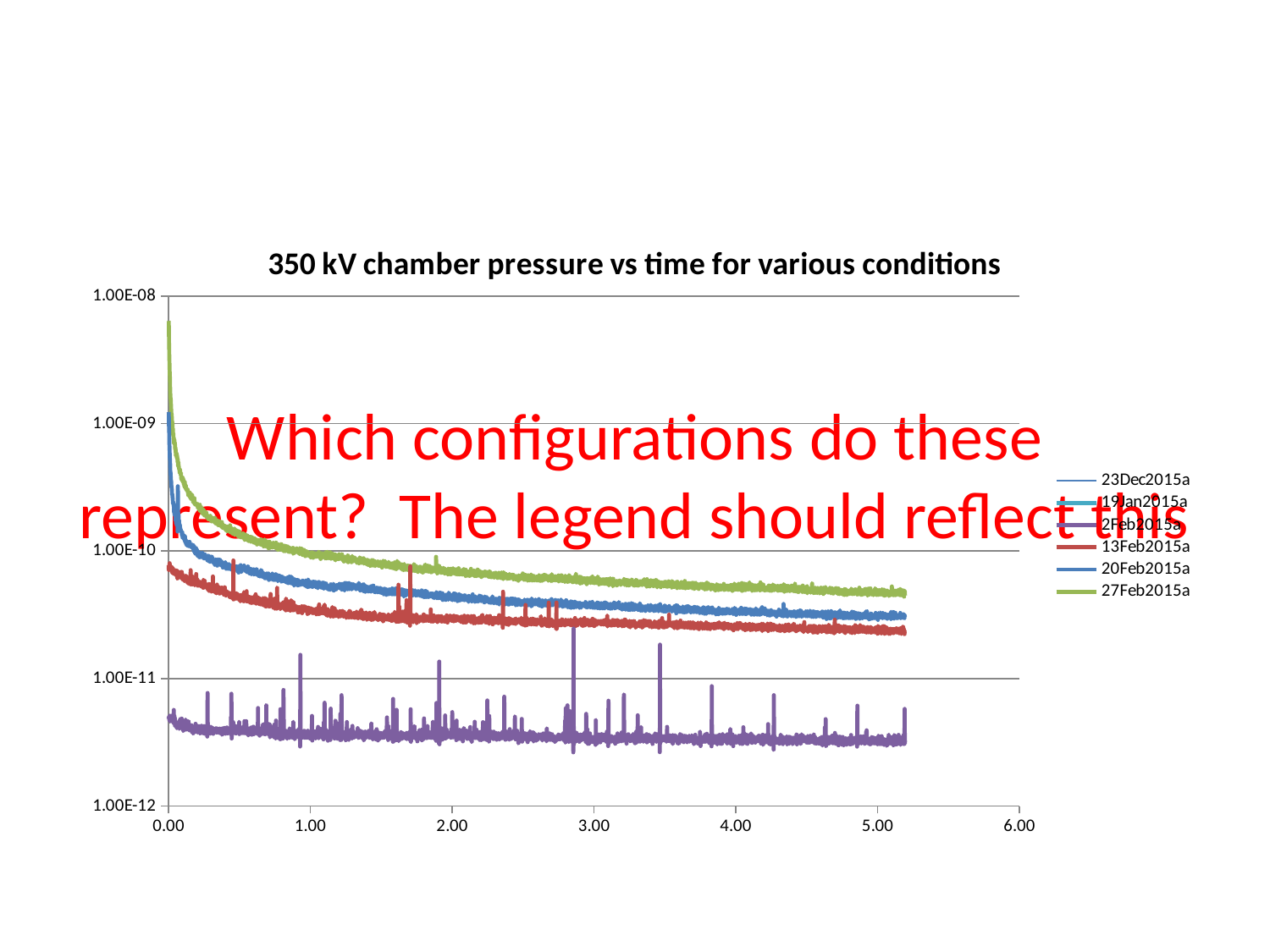
How many series does the legend list? 6 Which series has the highest pressure values across the plotted time range? 27Feb2015a At x = 4.00, which series has the higher value, 20Feb2015a or 2Feb2015a? 20Feb2015a What is the title of the chart? 350 kV chamber pressure vs time for various conditions Is the value for 13Feb2015a at x = 3.00 greater or less than 1.00E-10? less Do the pressure values for the 27Feb2015a series rise or fall as time increases along the x axis? fall Is the value for 2Feb2015a at x = 4.00 greater or less than 1.00E-11? less Which series has the lowest pressure values across the plotted time range? 2Feb2015a At x = 3.00, which series has the higher value, 27Feb2015a or 13Feb2015a? 27Feb2015a Is the value for 27Feb2015a at x = 4.00 greater or less than 1.00E-11? greater What kind of chart is shown on the slide? line chart What is the highest value shown on the x axis? 6.00